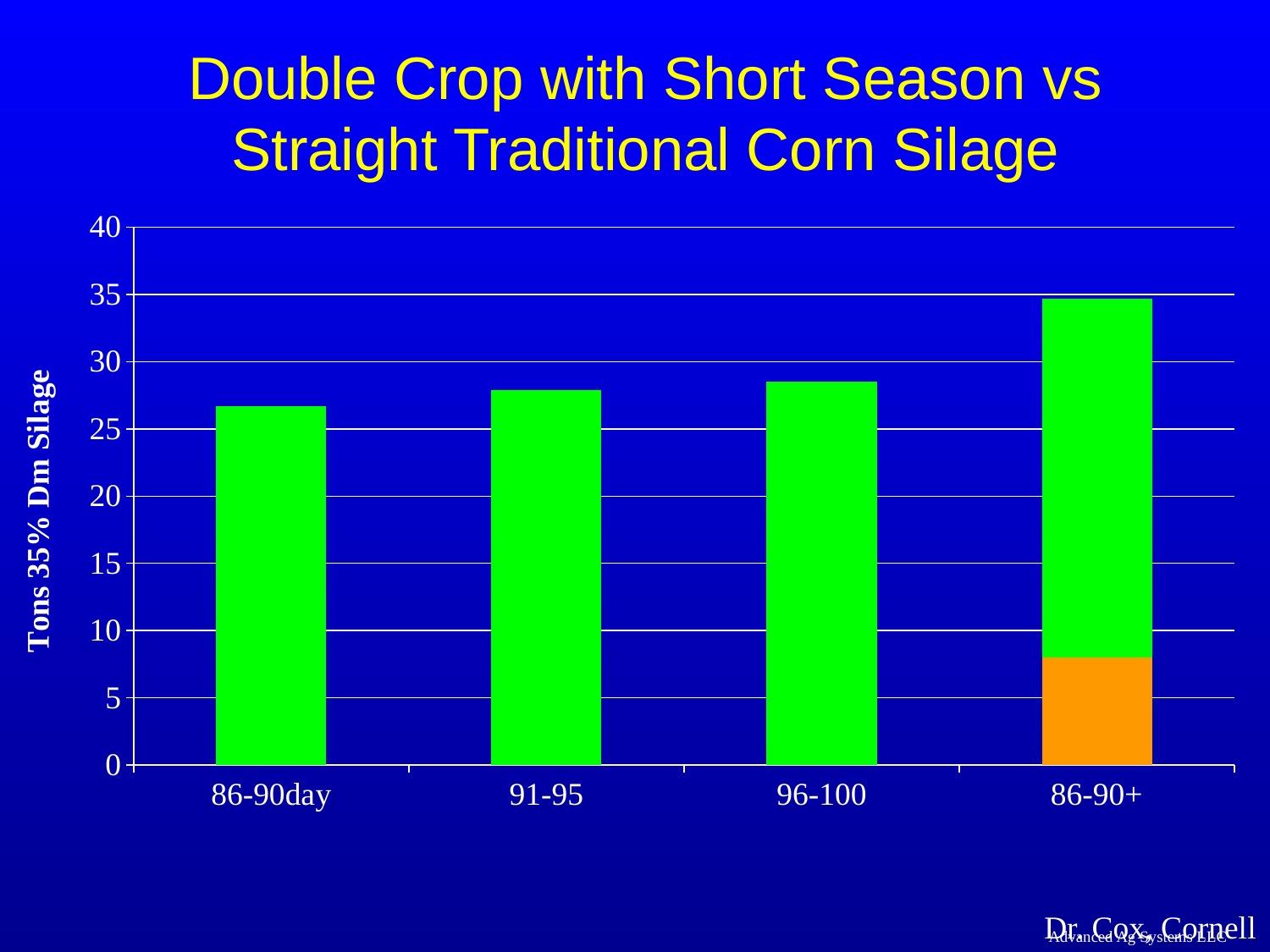
Which category has the lowest bar? 86-90day What kind of chart is shown on the slide? bar chart Do the bar heights rise or fall from left to right across the categories? rise What is the title of the y axis? Tons 35% Dm Silage Is the total for 86-90+ greater or less than 30? greater Is the value for 86-90day greater or less than 25? greater Which is larger, the bar for 86-90day or the bar for 86-90+? 86-90+ Which category has the highest total bar? 86-90+ How many categories are shown on the x axis? 4 Is the value for 96-100 greater or less than 30? less Which category's bar is made up of two colours (green and orange)? 86-90+